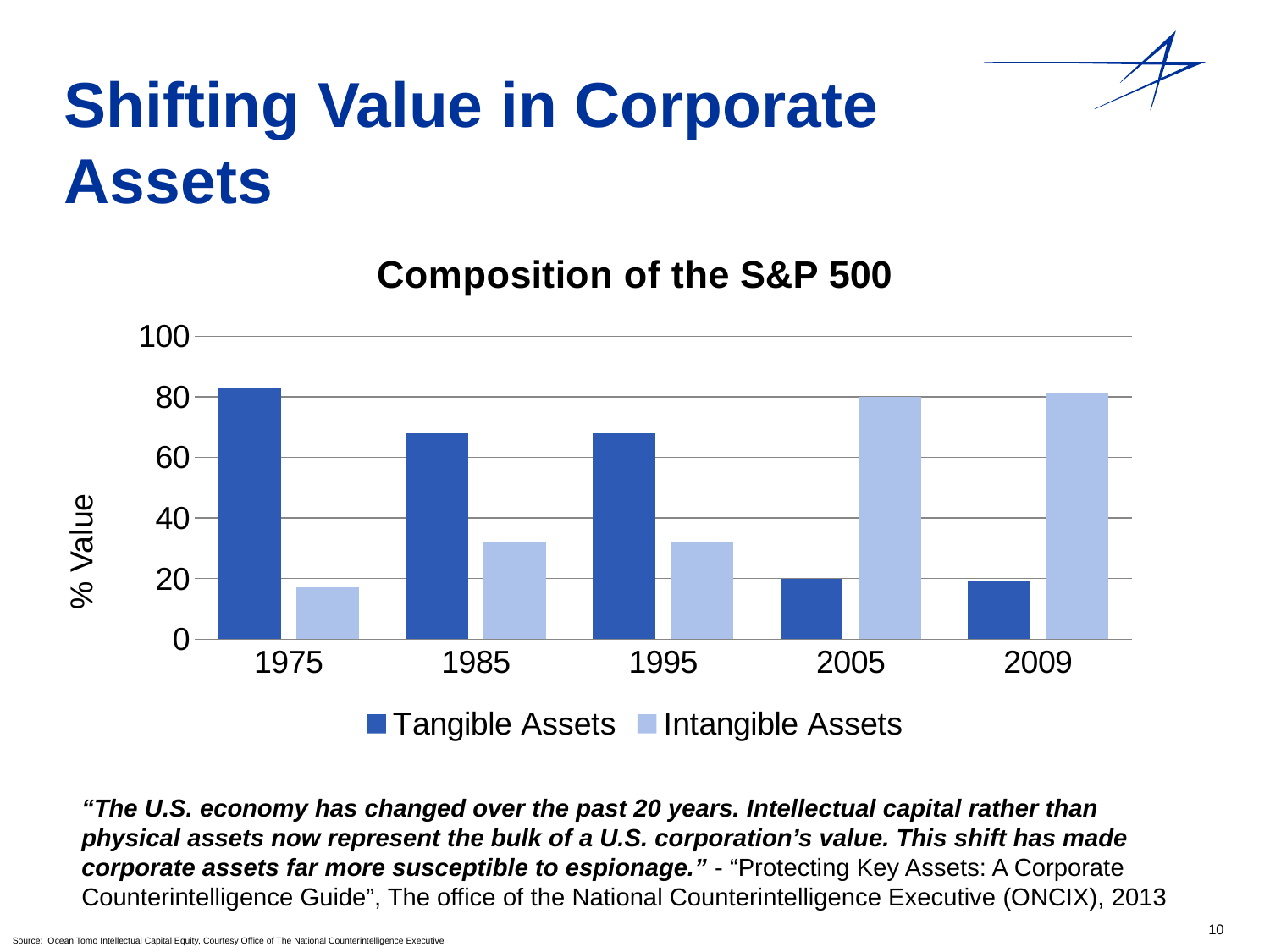
Is the value for Intangible Assets in 2009 greater or less than 60? greater What kind of chart is shown on the slide? bar chart Is the value for Tangible Assets in 1985 greater or less than 60? greater Do the values for Tangible Assets rise or fall from 1975 to 2009? fall In which year is the value for Tangible Assets highest? 1975 Is the value for Tangible Assets in 1975 greater or less than 80? greater In 2005, which is larger: Tangible Assets or Intangible Assets? Intangible Assets How many years are shown on the x axis? 5 How many series does the legend list? 2 What is the title of the chart? Composition of the S&P 500 In which year is the value for Intangible Assets lowest? 1975